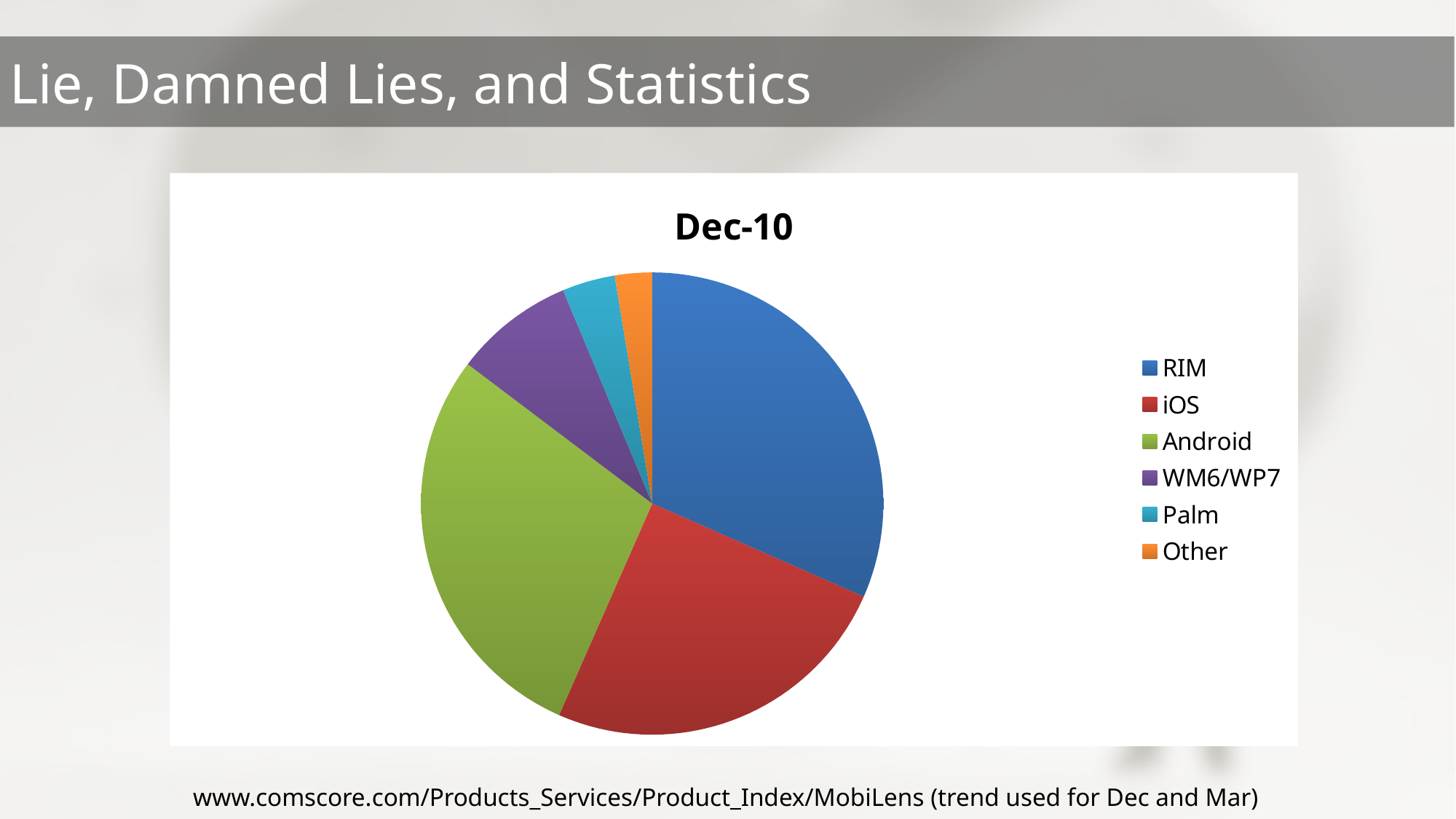
Which slice is larger, RIM or iOS? RIM Which category is shown in orange in the legend? Other What kind of chart is shown on the slide? pie chart Which category has the largest slice of the pie? RIM Which slice is larger, Android or iOS? Android Which slice is larger, WM6/WP7 or Other? WM6/WP7 How many categories does the legend of the pie chart list? 6 What colour is the RIM slice in the pie chart? blue What is the title of the chart? Dec-10